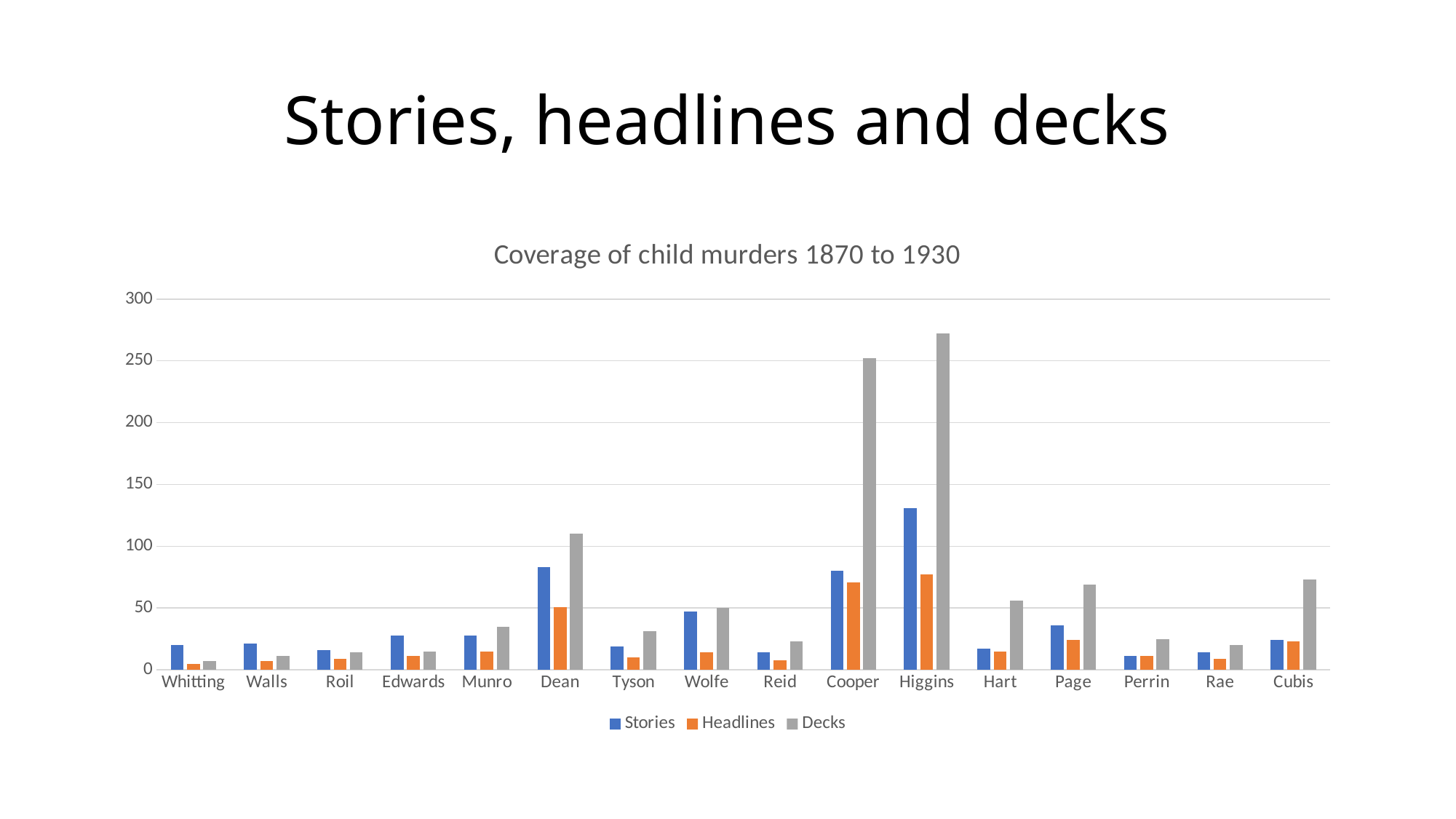
What kind of chart is shown on the slide? Bar chart Is the Stories value for Higgins greater or less than 100? greater Is the Decks value for Cubis greater or less than 50? greater How many categories are shown on the x axis? 16 What is the title of the chart? Coverage of child murders 1870 to 1930 Is the Stories value for Whitting greater or less than 50? less How many series does the legend list? 3 Which category has the highest Stories value? Higgins Which is larger, the Decks value for Hart or the Decks value for Page? Page Which colour represents the Headlines series in the legend? Orange Which category has the highest Decks value? Higgins